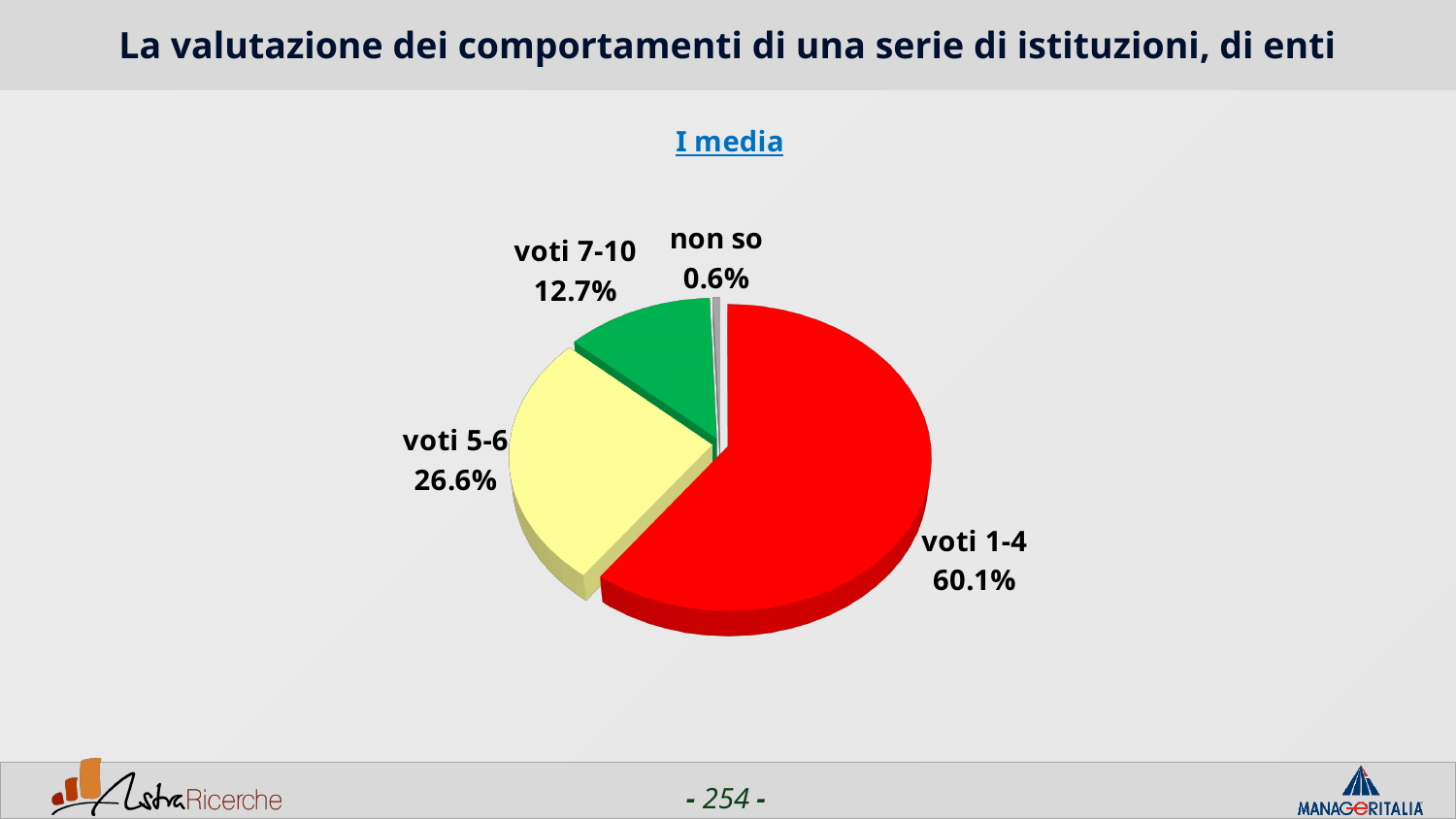
What kind of chart is shown on the slide? Pie chart What is the difference between the 'voti 1-4' and 'voti 5-6' values? 33.5% What is the value shown for 'voti 5-6'? 26.6% What is the title shown above the pie chart? I media What is the difference between the 'voti 5-6' and 'voti 7-10' values? 13.9% What is the value shown for 'non so'? 0.6% Which category has the smallest slice of the pie? non so Which category has the largest slice of the pie? voti 1-4 Which is larger, 'voti 7-10' or 'voti 5-6'? voti 5-6 How many slices does the pie chart have? 4 What is the value shown for 'voti 7-10'? 12.7% What share of the pie does the 'voti 1-4' slice represent? 60.1%